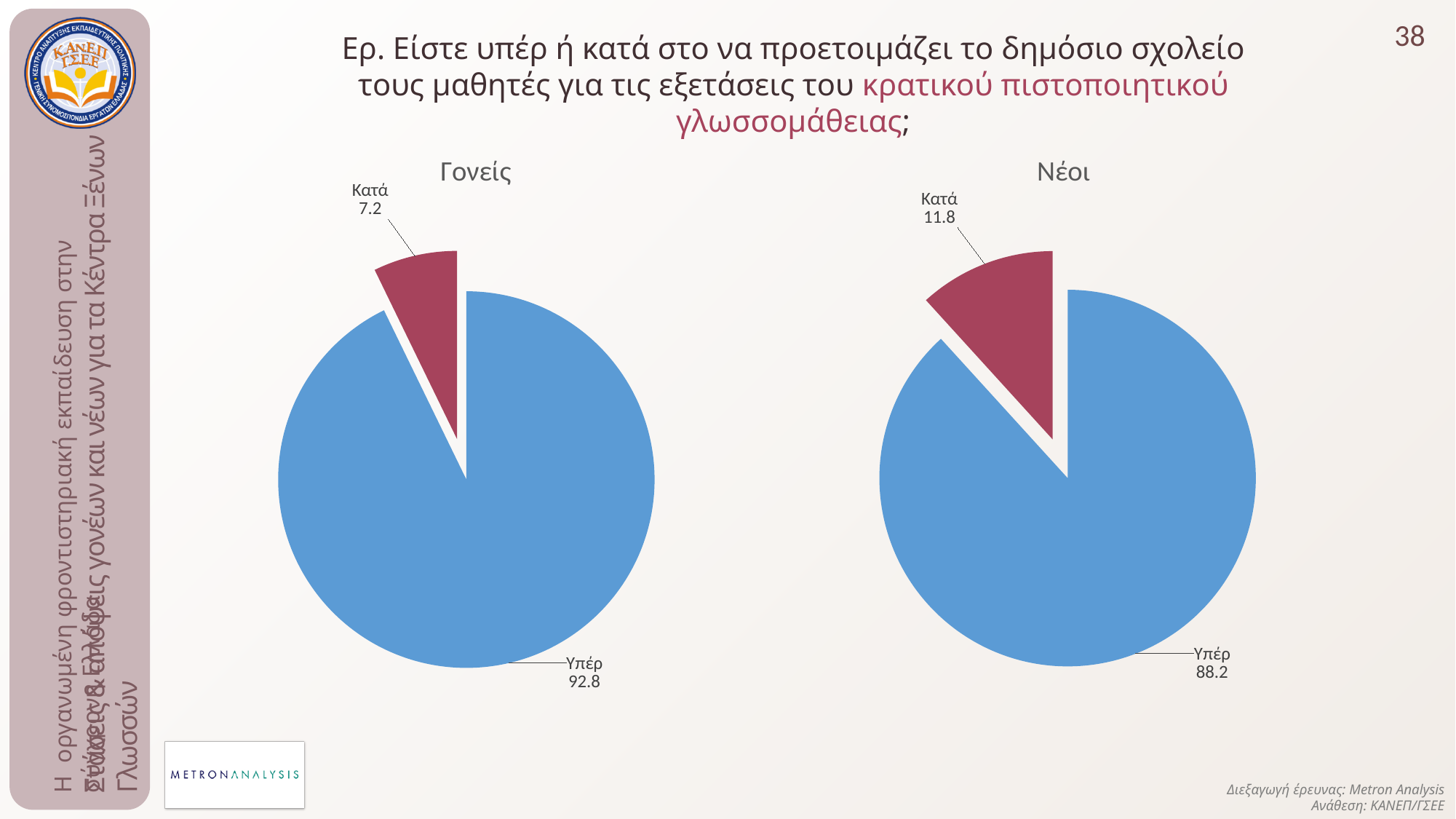
What colour is the Υπέρ slice in the Γονείς pie chart? Blue In the Νέοι pie chart, what is the value for Υπέρ? 88.2 In the Γονείς pie chart, what is the difference between Υπέρ and Κατά? 85.6 In the Γονείς pie chart, which slice is the largest? Υπέρ What type of chart is used for Γονείς? Pie chart In the Γονείς pie chart, what is the value for Υπέρ? 92.8 In the Νέοι pie chart, what is the value for Κατά? 11.8 In the Γονείς pie chart, what is the value for Κατά? 7.2 In the Νέοι pie chart, which slice is the smallest? Κατά In the Νέοι pie chart, what is the difference between Υπέρ and Κατά? 76.4 How many slices does the Νέοι pie chart have? 2 Which is larger: Κατά in the Γονείς chart or Κατά in the Νέοι chart? Κατά in the Νέοι chart